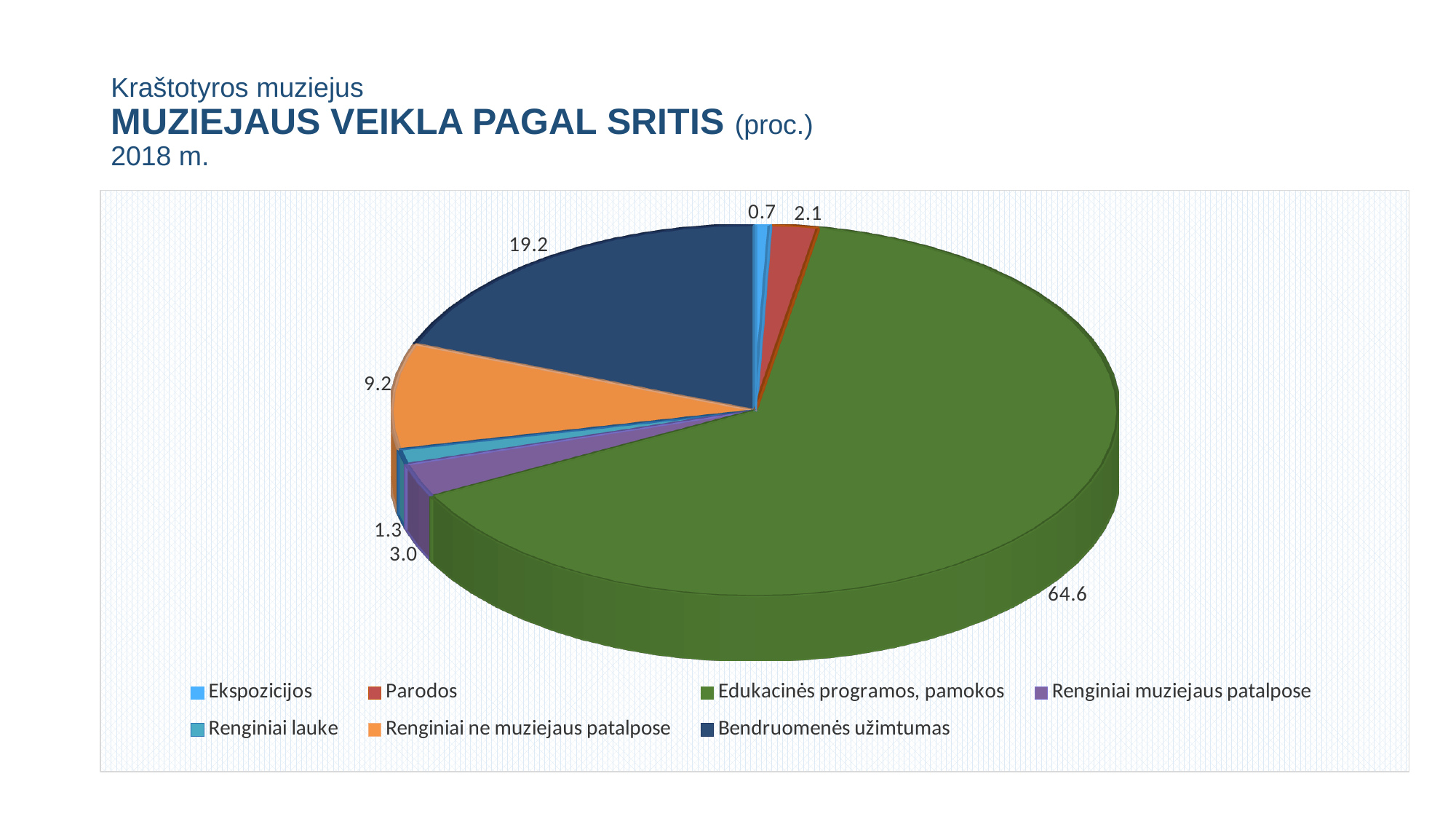
What year does the chart title refer to? 2018 m. What is the value for Edukacinės programos, pamokos? 64.6 What is the value for Renginiai ne muziejaus patalpose? 9.2 Which category has the largest share of the pie? Edukacinės programos, pamokos What type of chart is shown on the slide? Pie chart Which is larger, Renginiai muziejaus patalpose or Renginiai lauke? Renginiai muziejaus patalpose What is the value for Ekspozicijos? 0.7 What is the value for Bendruomenės užimtumas? 19.2 What is the value for Parodos? 2.1 What is the difference between the values for Bendruomenės užimtumas and Renginiai ne muziejaus patalpose? 10.0 Which category has the smallest share of the pie? Ekspozicijos How many categories does the pie chart have? 7